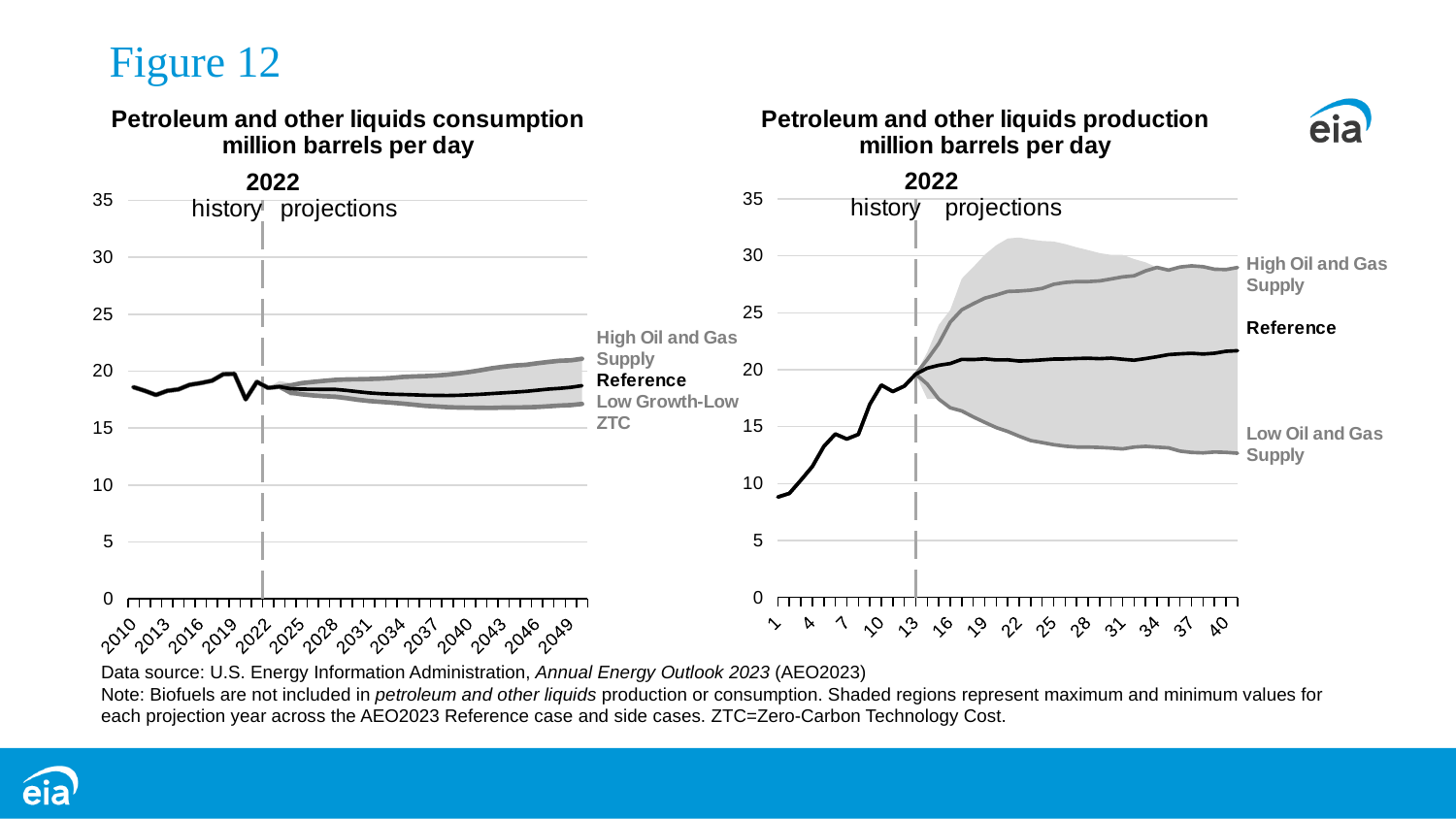
On the 'Petroleum and other liquids consumption' chart, how many labeled scenario lines are shown in the projection period? 3 On the 'Petroleum and other liquids production' chart, is the Reference value at the end of the projection period greater or less than 20? greater On the 'Petroleum and other liquids production' chart, which scenario has the highest value at the end of the projection period? High Oil and Gas Supply On the 'Petroleum and other liquids production' chart, is the High Oil and Gas Supply value at the end of the projection period greater or less than 25? greater On the 'Petroleum and other liquids production' chart, which scenario has the lowest value at the end of the projection period? Low Oil and Gas Supply On the 'Petroleum and other liquids consumption' chart, is the Low Growth-Low ZTC value in 2049 greater or less than 20? less On the 'Petroleum and other liquids production' chart, does the history line rise or fall from year 1 to year 13? rises On the 'Petroleum and other liquids production' chart, which is larger at the end of the projection period, High Oil and Gas Supply or Reference? High Oil and Gas Supply What kind of chart is the 'Petroleum and other liquids consumption' chart on the left? line chart What year does the vertical dashed line separating history from projections mark on both charts? 2022